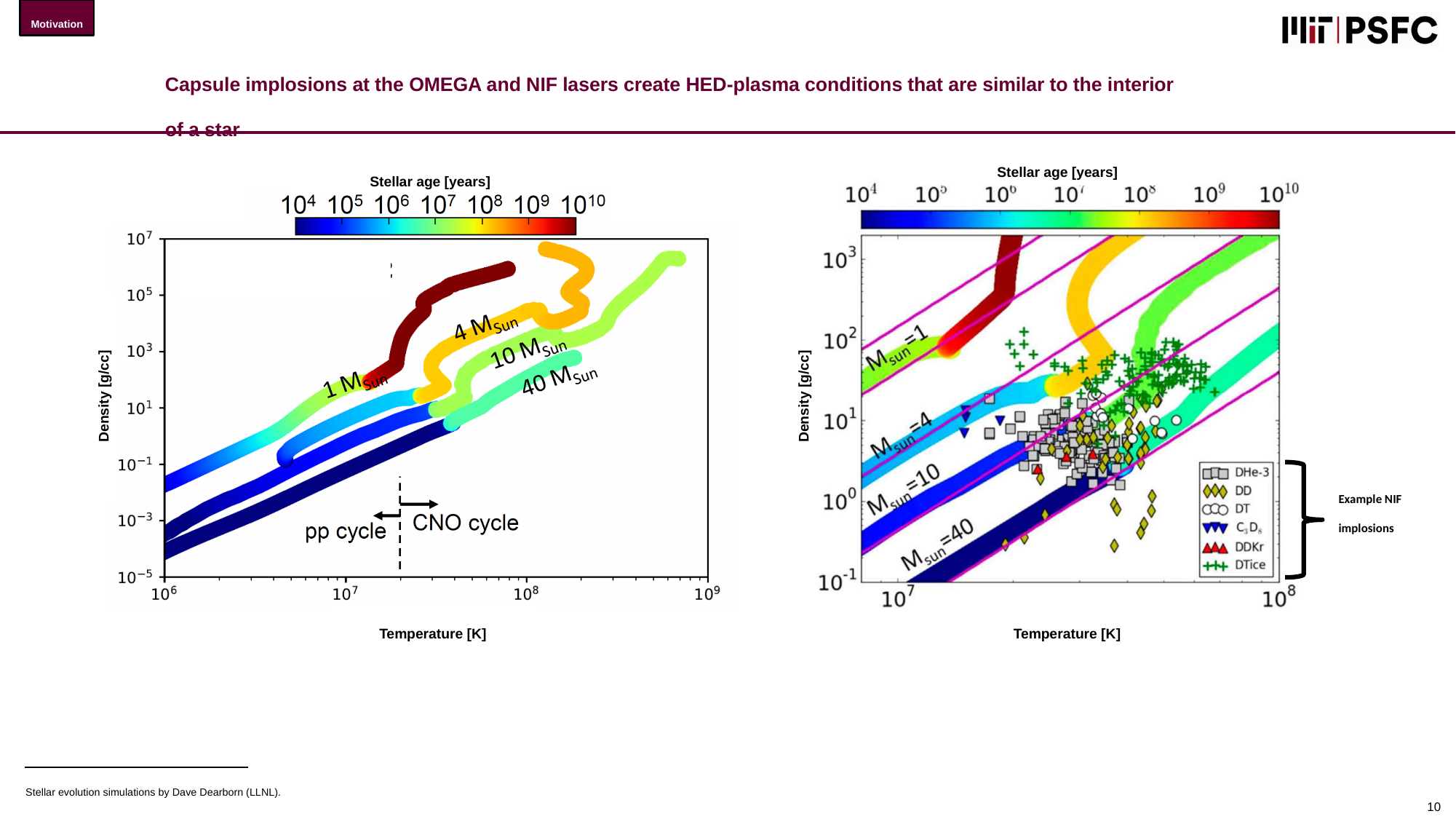
In the left chart, what quantity is plotted on the y-axis? Density [g/cc] In the right chart, how many series does the legend list? 6 In the left chart, how many stellar mass tracks are labeled? 4 In the left chart, which stellar mass track is labeled with the largest mass? 40 M_Sun In the left chart, what quantity is plotted on the x-axis? Temperature [K] In the left chart, which burning cycle is labeled to the left of the dashed vertical line? pp cycle In the left chart, which stellar mass track is labeled with the smallest mass? 1 M_Sun In the right chart, which legend entry is represented by green plus signs? DTice How many charts are shown on the slide? 2 In the left chart, at a temperature of 10^6 K, is the density of the 1 M_Sun track greater or less than 10^1 g/cc? less In the right chart, what is the highest value shown on the stellar age colour bar? 10^10 In the left chart, does the density of the stellar tracks rise or fall as temperature increases along the x-axis? rise